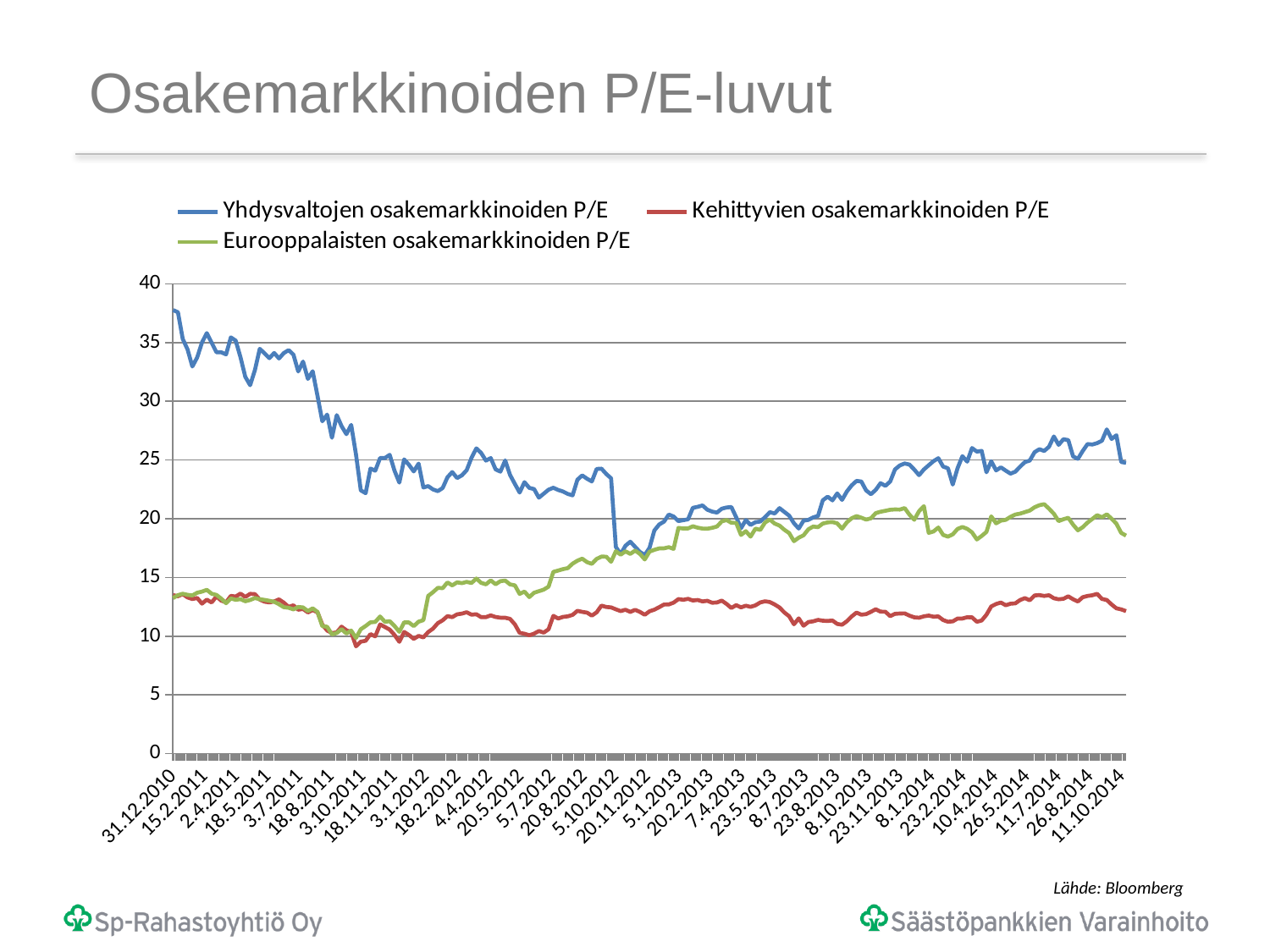
Is the value of Kehittyvien osakemarkkinoiden P/E at 11.10.2014 greater or less than 15? less How many series does the legend list? 3 Does the Eurooppalaisten osakemarkkinoiden P/E line rise or fall between 3.10.2011 and 5.1.2013? rise What is the title of the chart? Osakemarkkinoiden P/E-luvut At 11.10.2014, which is higher: Yhdysvaltojen osakemarkkinoiden P/E or Eurooppalaisten osakemarkkinoiden P/E? Yhdysvaltojen osakemarkkinoiden P/E What kind of chart is shown on the slide? line chart What source is cited for the chart data? Bloomberg Is the value of Yhdysvaltojen osakemarkkinoiden P/E at 3.7.2011 greater or less than 30? greater Which series has the lowest value at 11.10.2014? Kehittyvien osakemarkkinoiden P/E Is the value of Eurooppalaisten osakemarkkinoiden P/E at 11.10.2014 greater or less than 15? greater Does the Yhdysvaltojen osakemarkkinoiden P/E line rise or fall between 31.12.2010 and 3.10.2011? fall